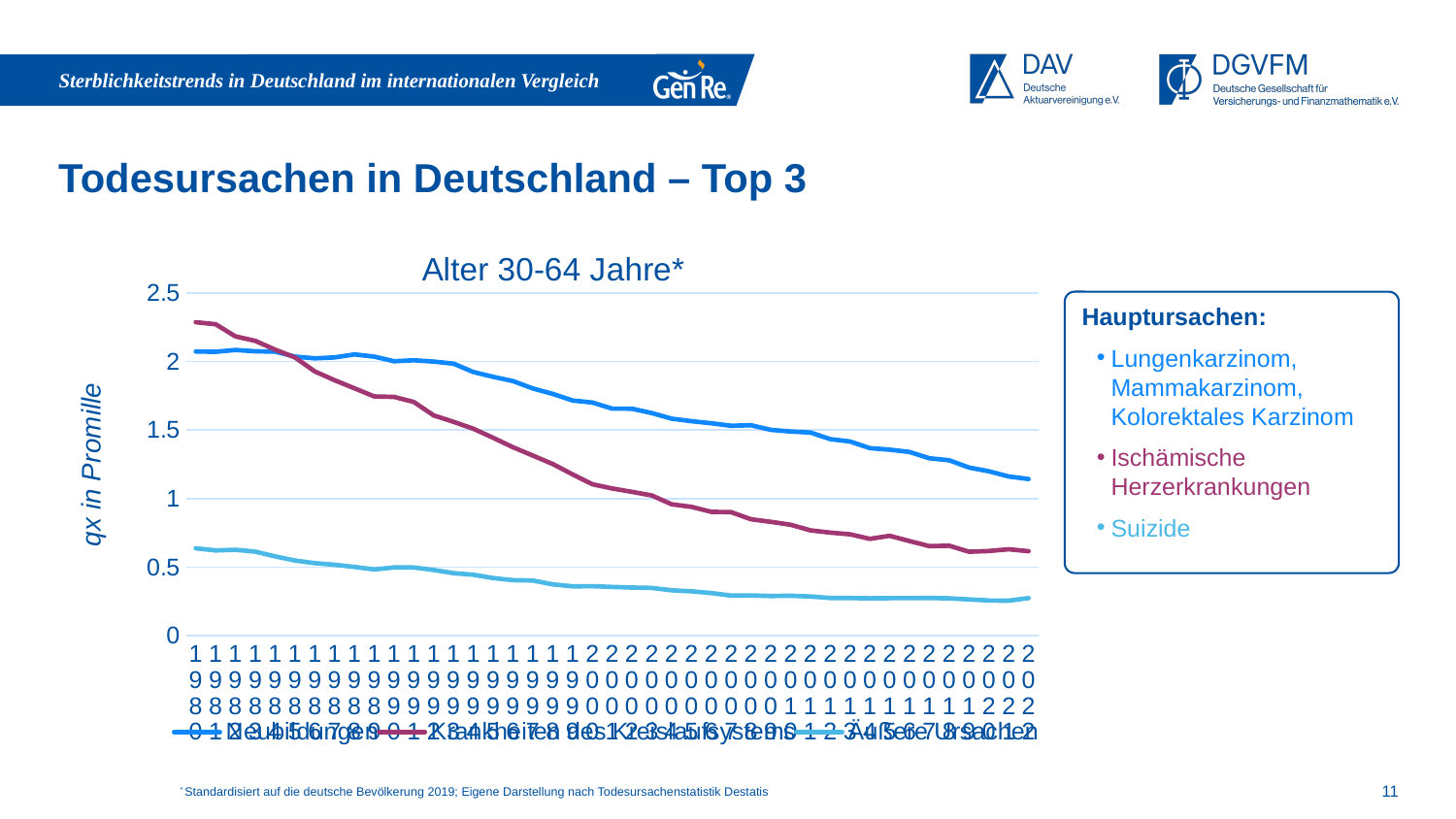
Does the dark red line rise or fall from left to right along the x axis? fall Which line has the lowest values across the whole chart? the light blue line What kind of chart is shown on the slide? line chart What is the label of the vertical axis of the chart? qx in Promille What is the title of the chart? Alter 30-64 Jahre* Is the value of the dark red line at the right end of the chart (2022) greater or less than 1? less Is the value of the light blue line at the right end of the chart (2022) greater or less than 0.5? less Does the light blue line rise or fall from left to right along the x axis? fall How many lines are plotted in the chart? 3 At the left end of the chart (1980), which line is higher: the blue line or the dark red line? the dark red line Is the value of the dark red line at the left end of the chart (1980) greater or less than 2? greater